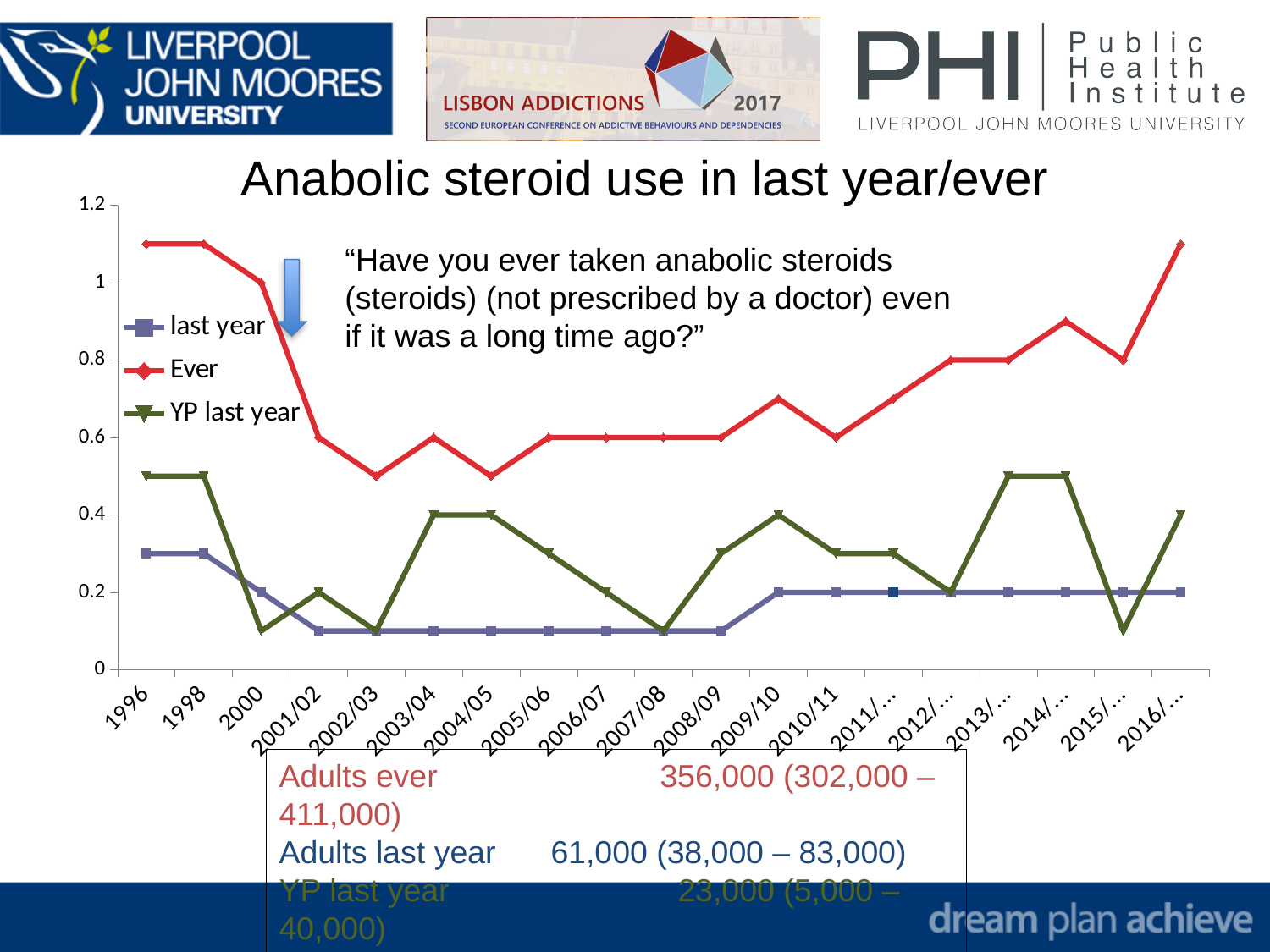
Is the value for YP last year at 2013/... greater or less than 0.4? greater Which series has the highest value at 2016/...? Ever Is the value for Ever at 1996 greater or less than 1? greater How many time points are shown along the x axis of the chart? 19 At 1996, which is larger: the value for Ever or the value for last year? Ever What kind of chart is shown on the slide? line chart Which series are listed in the chart's legend? last year, Ever, YP last year Does the Ever series rise or fall between 1998 and 2001/02? fall What is the value for YP last year at 2003/04? 0.4 What is the title of the chart? Anabolic steroid use in last year/ever Is the value for last year at 2002/03 greater or less than 0.2? less How many series does the chart's legend list? 3